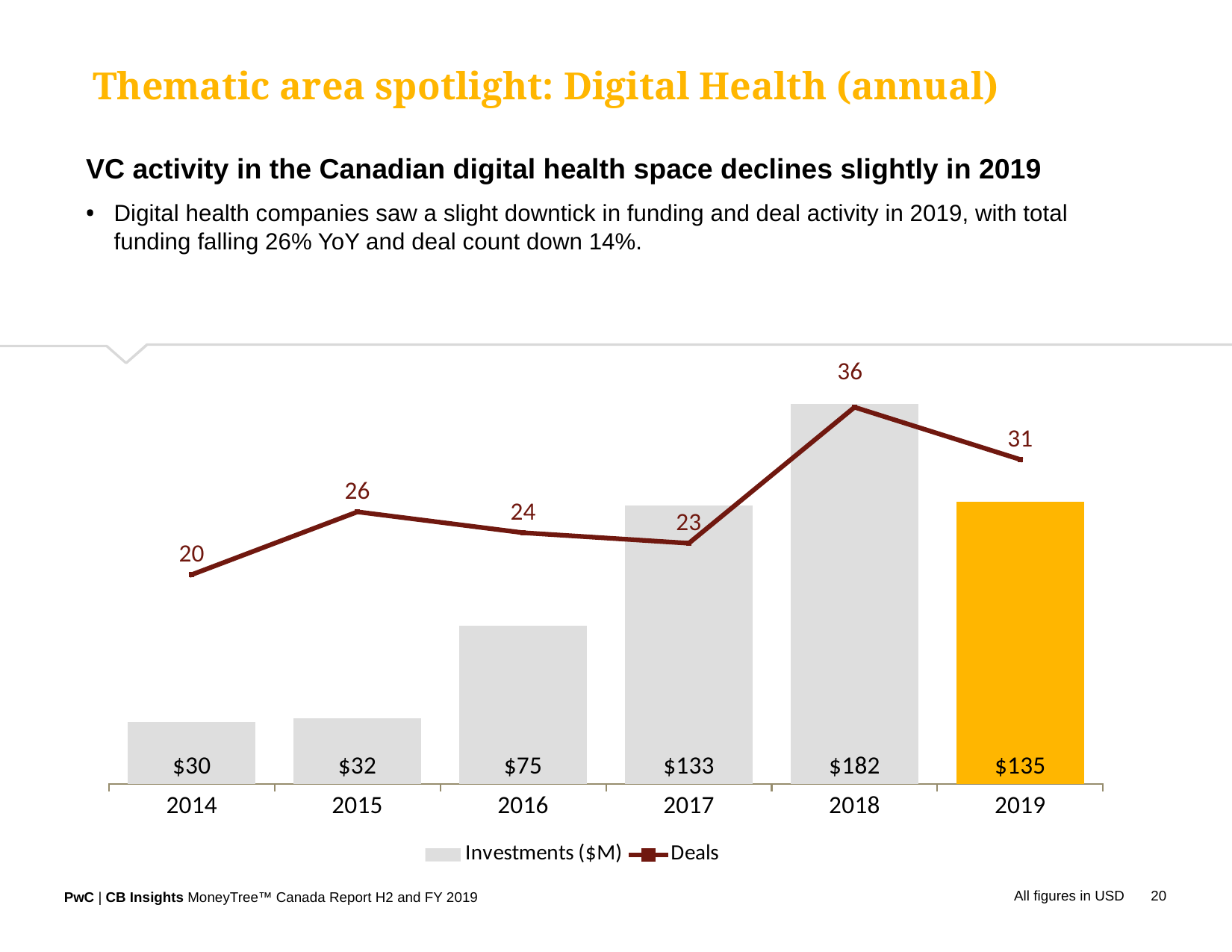
Which year has the highest Investments ($M)? 2018 What is the difference in Investments ($M) between 2018 and 2019? $47 How many more Deals were there in 2018 than in 2017? 13 Which year's Investments bar is coloured orange instead of grey? 2019 How many years are shown on the x axis? 6 What is the value of Investments ($M) for 2019? $135 What kind of chart is used to show Investments ($M)? Bar chart How many series does the legend list? 2 What is the value of Investments ($M) for 2018? $182 How many Deals were there in 2015? 26 Which year has the lowest number of Deals? 2014 Which year had more Deals, 2016 or 2019? 2019